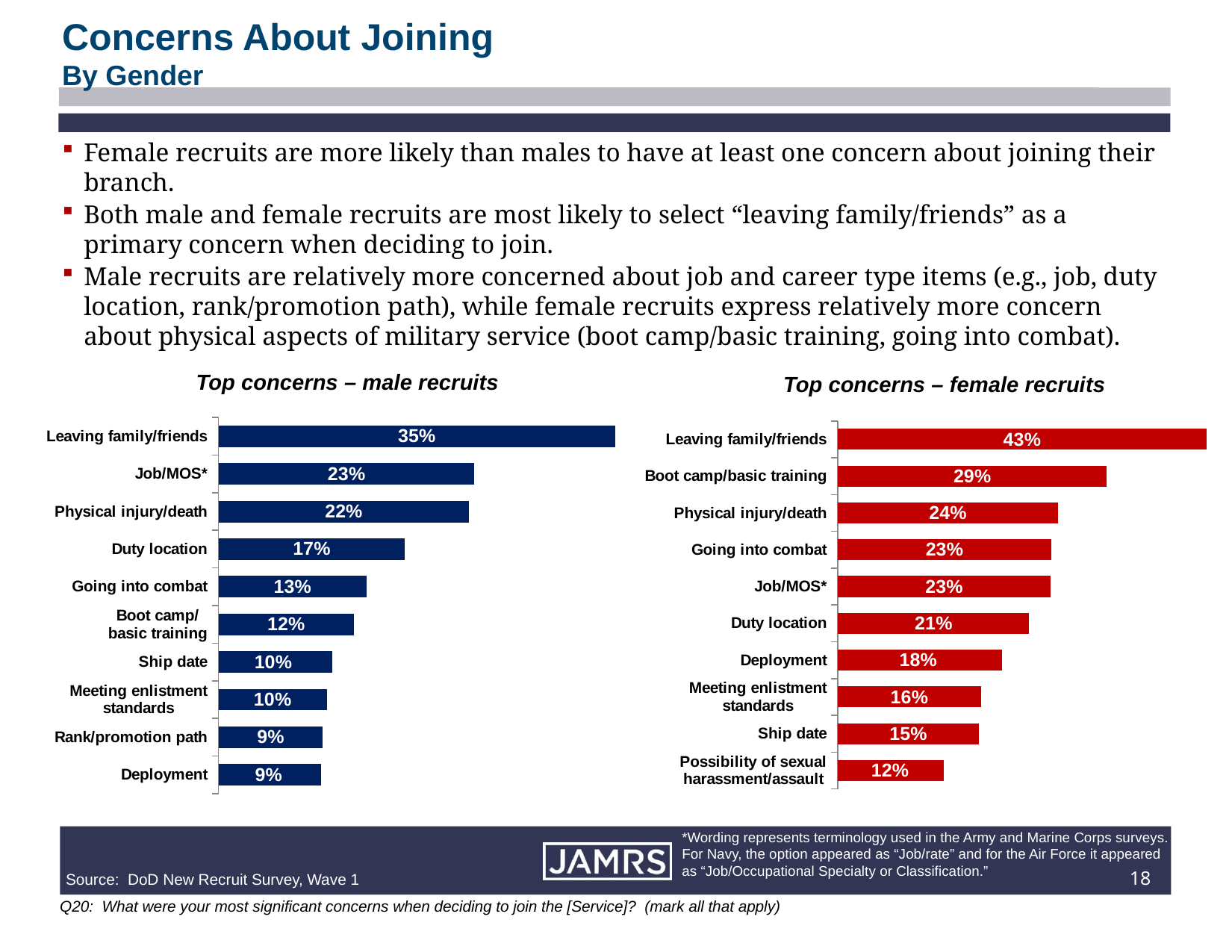
In the 'Top concerns – male recruits' chart, what is the difference between Leaving family/friends and Job/MOS*? 12% In the 'Top concerns – male recruits' chart, which category has the highest value? Leaving family/friends In the 'Top concerns – female recruits' chart, what is the value for Possibility of sexual harassment/assault? 12% In the 'Top concerns – female recruits' chart, which is larger: Deployment or Ship date? Deployment In the 'Top concerns – female recruits' chart, which category has the lowest value? Possibility of sexual harassment/assault In the 'Top concerns – male recruits' chart, what is the value for Duty location? 17% In the 'Top concerns – female recruits' chart, what is the difference between Leaving family/friends and Deployment? 25% In the 'Top concerns – female recruits' chart, what is the value for Boot camp/basic training? 29% What colour are the bars in the 'Top concerns – female recruits' chart? Red What kind of chart is the 'Top concerns – female recruits' chart? Bar chart How many categories are shown in the 'Top concerns – male recruits' chart? 10 In the 'Top concerns – male recruits' chart, which is larger: Going into combat or Boot camp/basic training? Going into combat